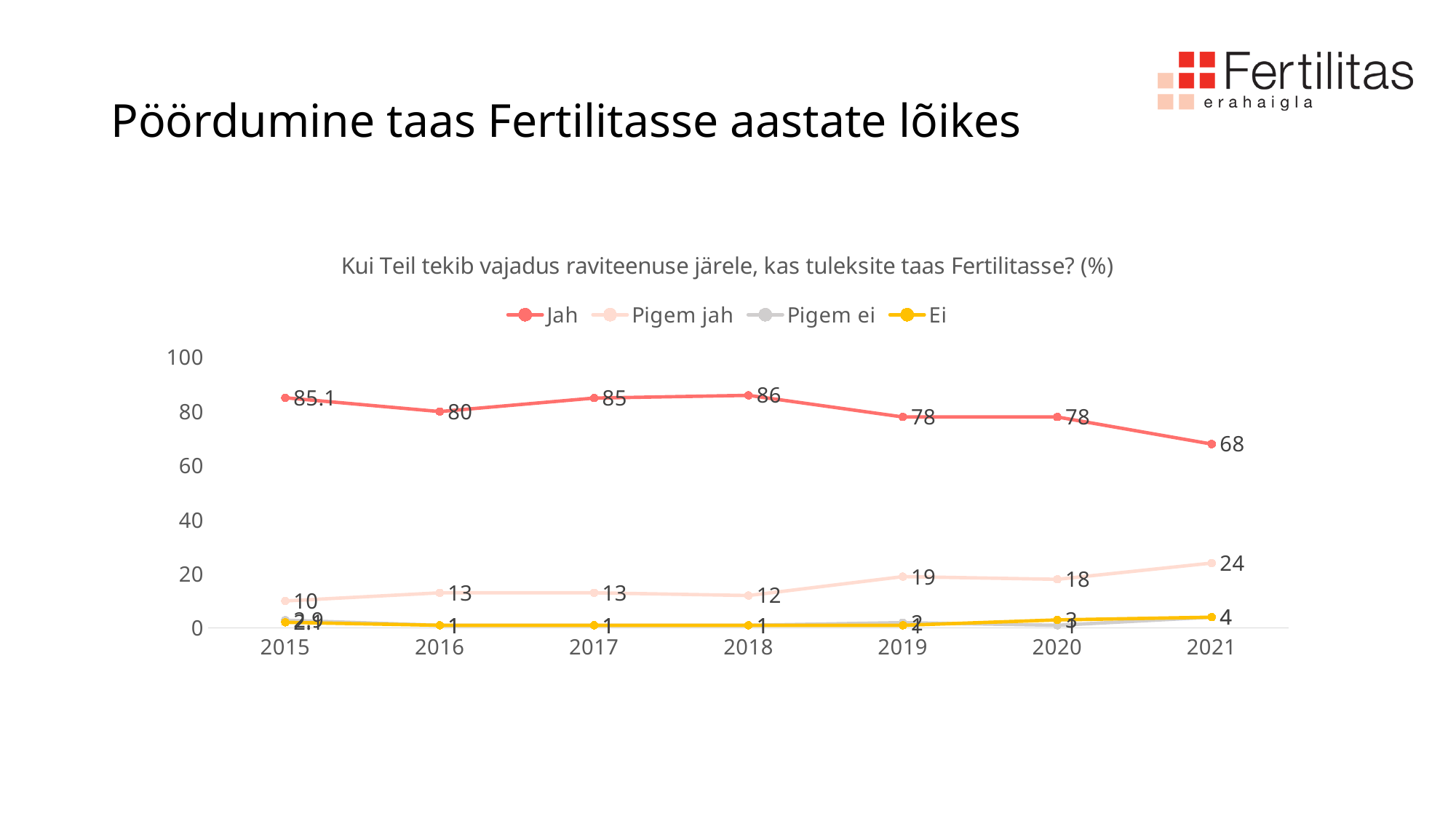
What is the value for Jah in 2021? 68 In which year is the Jah value highest? 2018 How many years are shown on the x axis? 7 In which year is the Jah value lowest? 2021 Does the Pigem jah series generally rise or fall from 2015 to 2021? rise Which is larger, the Pigem jah value in 2016 or in 2020? 2020 What is the difference between the Jah values in 2018 and 2021? 18 What is the value for Pigem jah in 2021? 24 What is the value for Jah in 2015? 85.1 What type of chart is shown on the slide? line chart What is the value for Pigem jah in 2019? 19 How many series does the legend list? 4